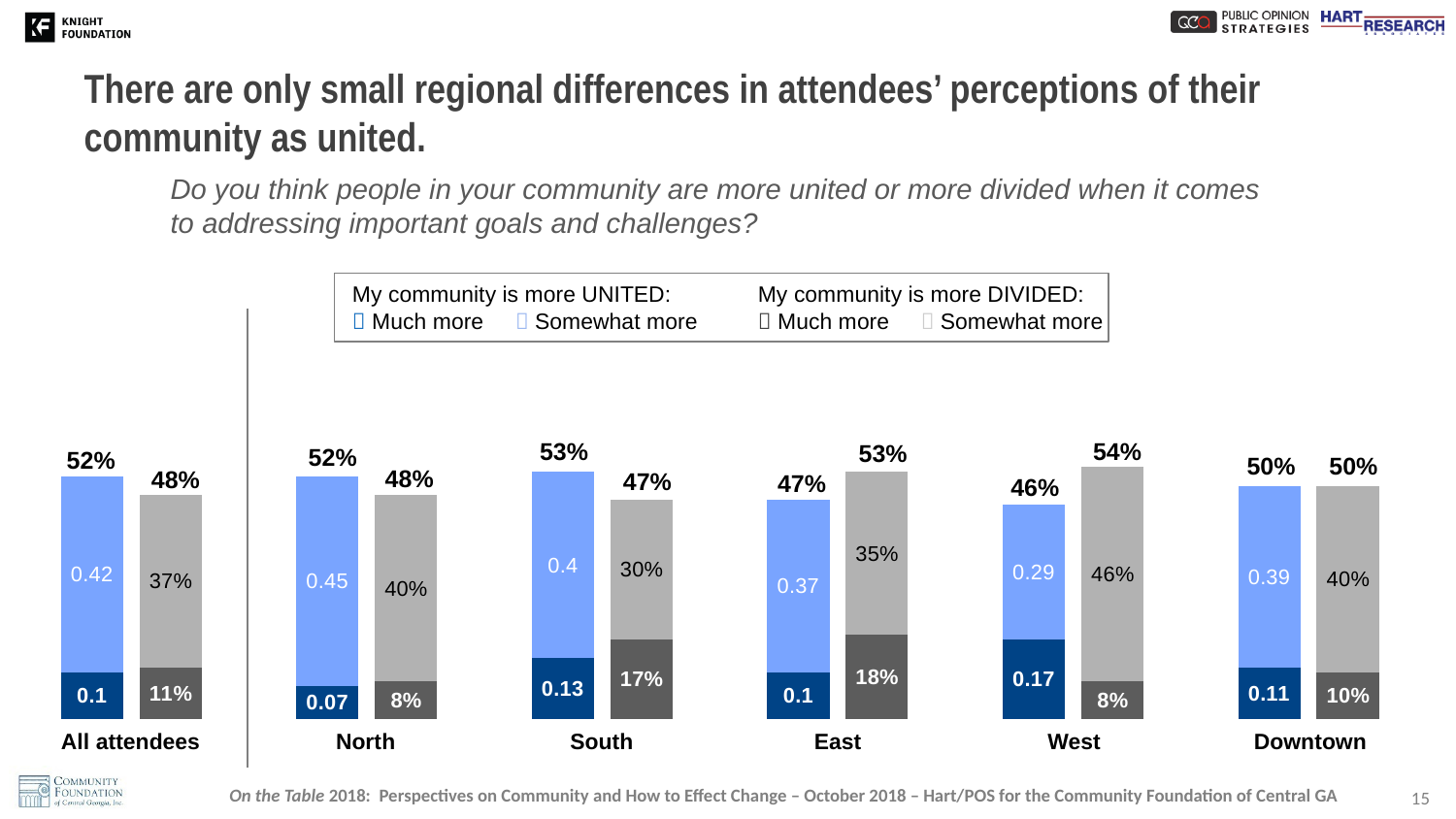
Which region has the lowest total percentage saying their community is more UNITED? West What is the total percentage saying their community is more DIVIDED in the West? 54% What is the total DIVIDED percentage for Downtown? 50% What is the difference between the total UNITED and total DIVIDED percentages in the South? 6% In the East, which is larger: the total percentage saying more UNITED or the total saying more DIVIDED? More DIVIDED What type of chart is used on this slide? Stacked bar chart What value is printed on the 'Somewhat more united' (light blue) segment for the North? 0.45 How many response categories does the legend list? 4 How many regional groups (including All attendees) are shown along the bottom of the chart? 6 What value is printed on the 'Much more divided' (dark gray) segment for the East? 18% Which region has the highest total percentage saying their community is more DIVIDED? West What is the total percentage of attendees who say their community is more UNITED among All attendees? 52%